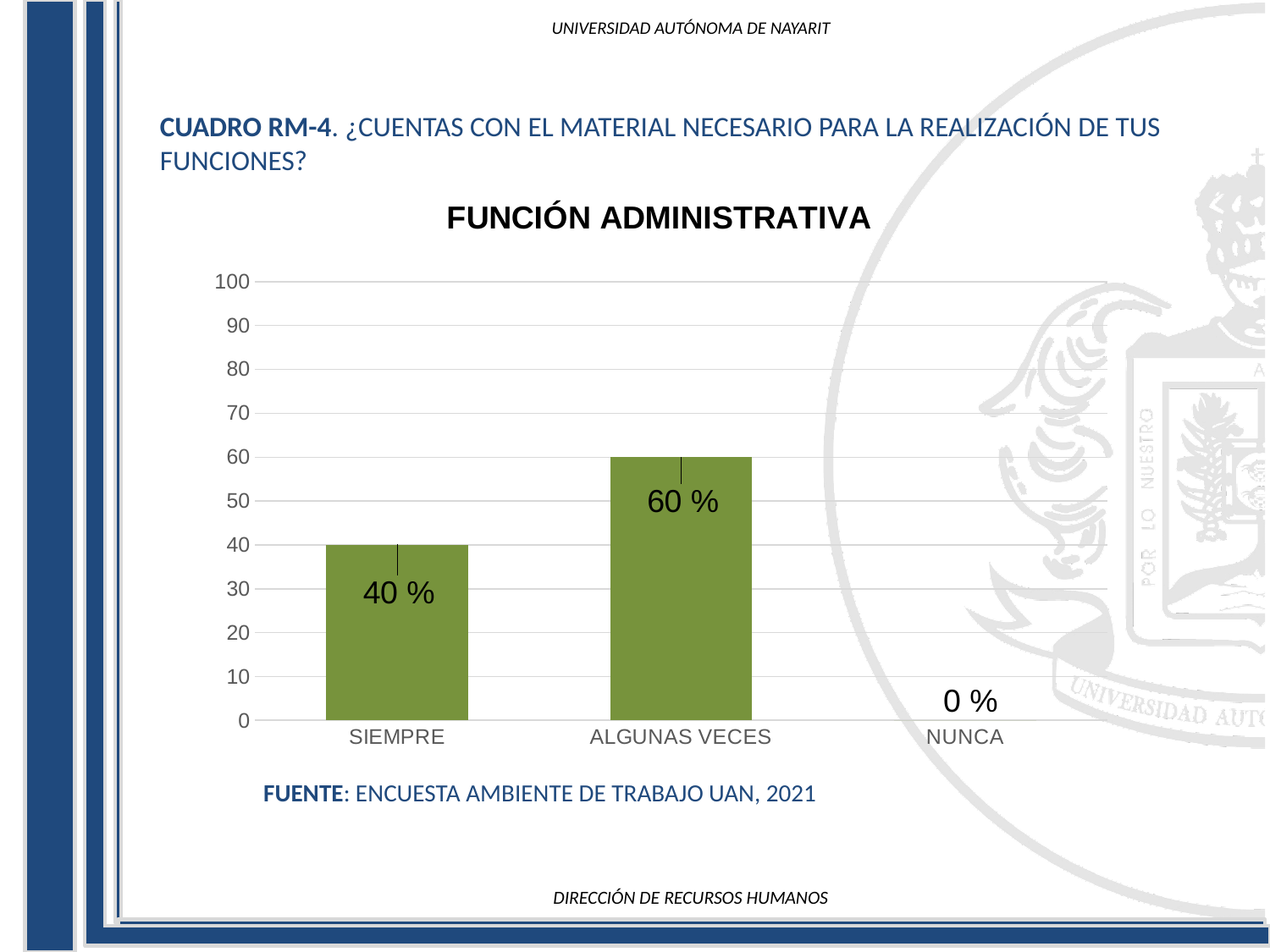
What is the value for SIEMPRE? 40 % Which category has the lowest value? NUNCA What is the maximum value shown on the y axis? 100 What is the value for ALGUNAS VECES? 60 % What is the difference between the values for ALGUNAS VECES and SIEMPRE? 20 % What kind of chart is shown on the slide? bar chart Which is larger, the value for SIEMPRE or the value for ALGUNAS VECES? ALGUNAS VECES Is the value for ALGUNAS VECES greater or less than 50? greater How many categories are shown on the x axis? 3 What is the title of the chart? FUNCIÓN ADMINISTRATIVA What is the value for NUNCA? 0 % Which category has the highest value? ALGUNAS VECES